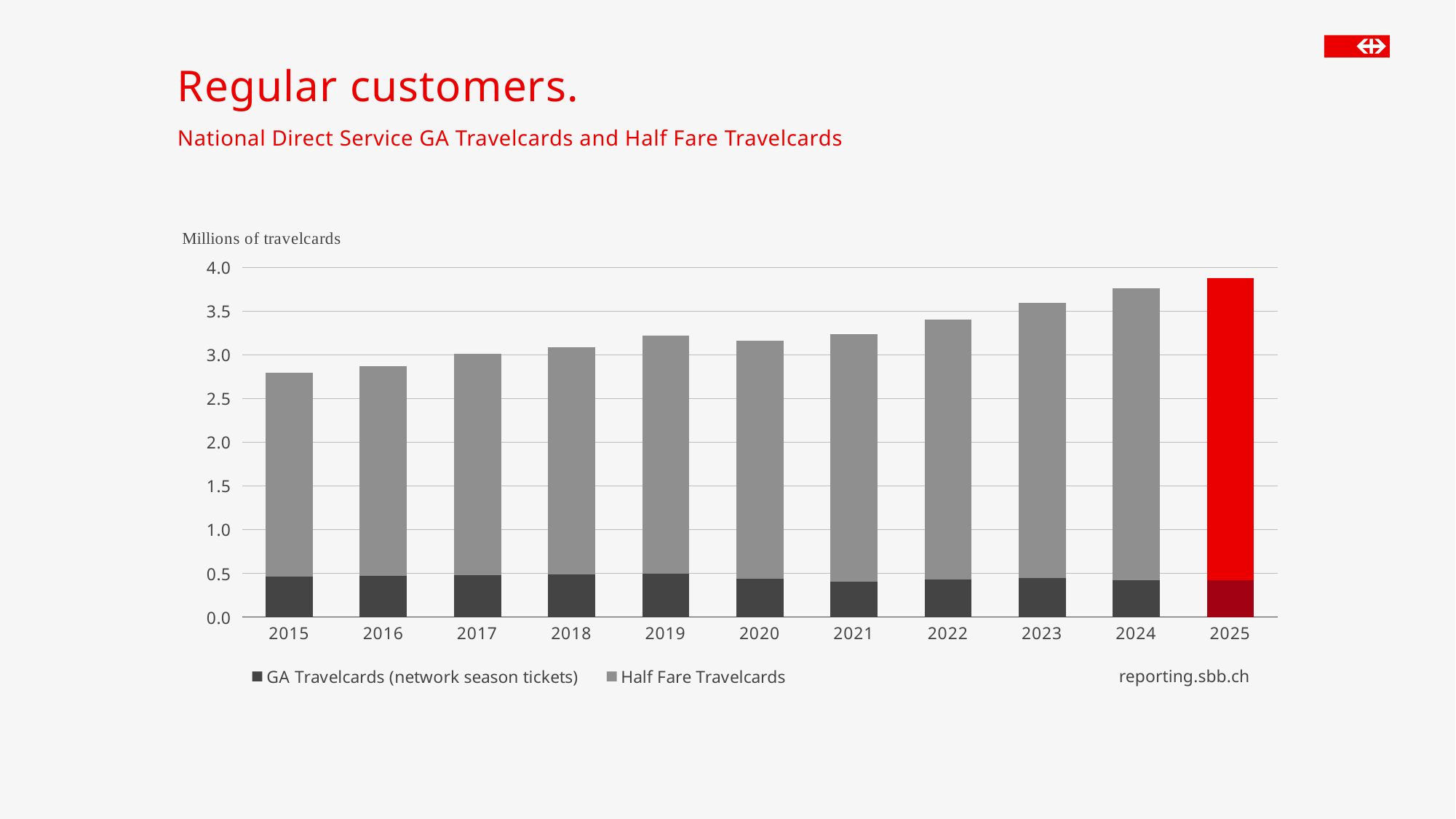
Is the number of GA Travelcards in 2019 greater or less than 1.0 million? less Is the total number of travelcards in 2022 greater or less than 3.5 million? less How many series does the chart legend list? 2 What unit is given for the y axis of the chart? Millions of travelcards Which year has the larger total number of travelcards, 2020 or 2024? 2024 Which year has the lowest total number of travelcards? 2015 How many years are shown on the x axis of the chart? 11 Which year has the highest total number of travelcards? 2025 What kind of chart is shown on the slide? Stacked bar chart Is the total number of travelcards in 2025 greater or less than 3.5 million? greater Does the total number of travelcards generally rise or fall from 2015 to 2025? rise